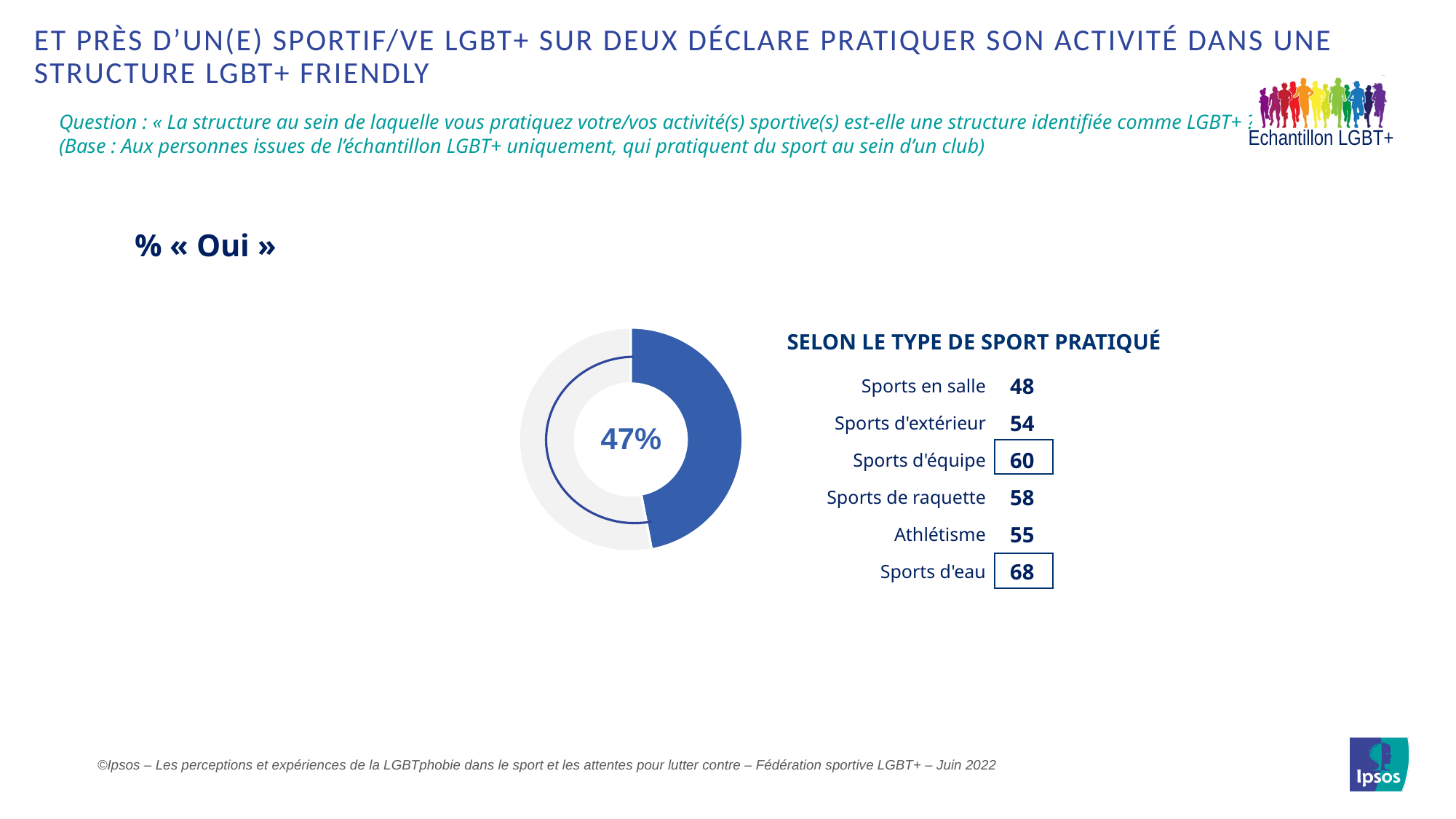
What share of the donut chart is not covered by the « Oui » slice? 53% In the breakdown 'Selon le type de sport pratiqué', what is the value for Sports d'équipe? 60 In the breakdown 'Selon le type de sport pratiqué', what is the difference between Sports d'eau and Sports en salle? 20 How many slices does the donut chart have? 2 In the breakdown 'Selon le type de sport pratiqué', which sport type has the lowest value? Sports en salle In the breakdown 'Selon le type de sport pratiqué', which sport type has the highest value? Sports d'eau What kind of chart is shown on the slide? Pie (donut) chart In the breakdown 'Selon le type de sport pratiqué', which is larger: Sports de raquette or Sports d'extérieur? Sports de raquette How many sport types are listed in the breakdown 'Selon le type de sport pratiqué'? 6 In the breakdown 'Selon le type de sport pratiqué', what is the value for Athlétisme? 55 What percentage of respondents answered « Oui » according to the donut chart? 47% Is the « Oui » share in the donut chart greater or less than 50%? less